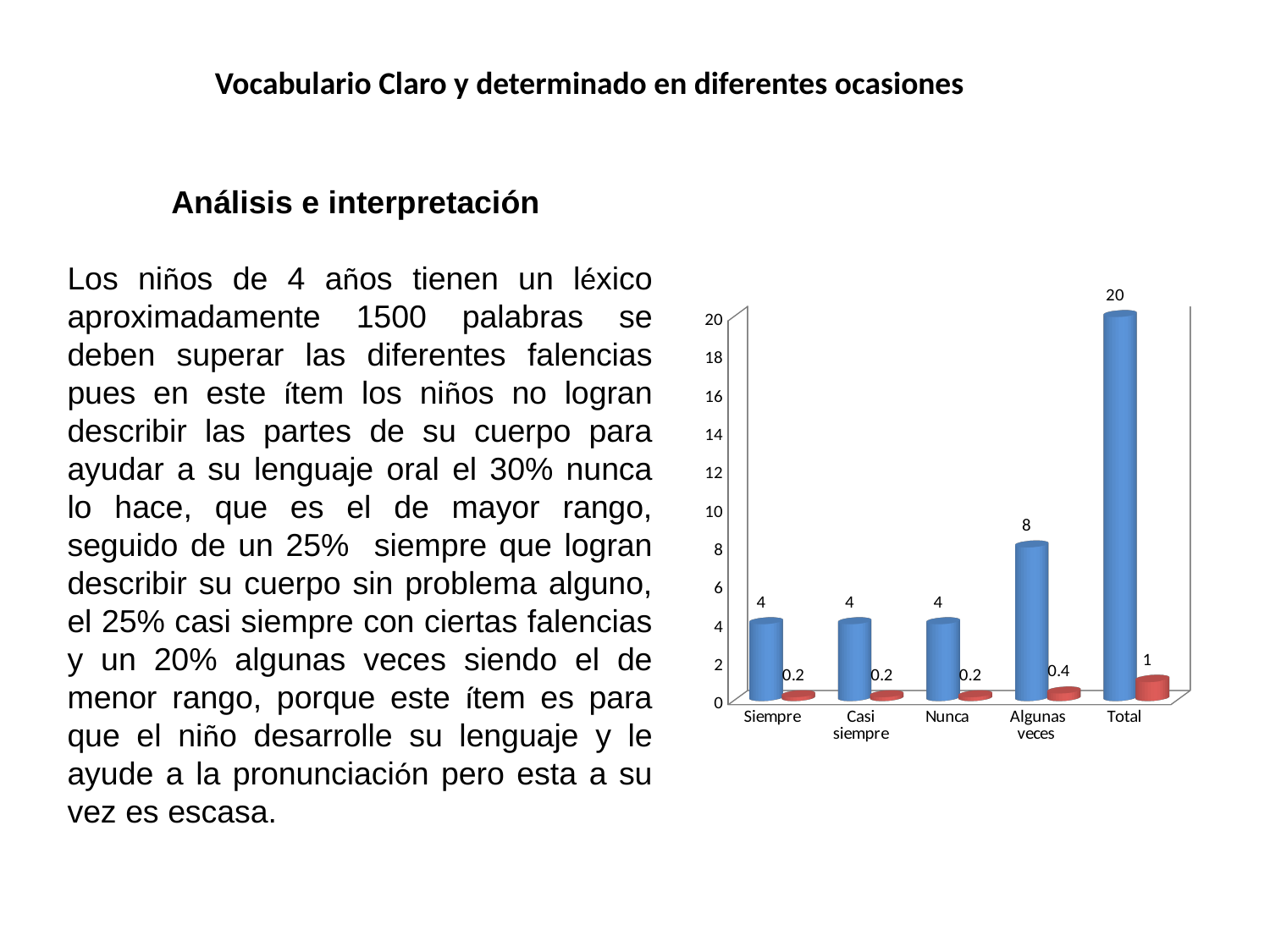
What is the value of the blue bar for Total? 20 What is the value of the red bar for Total? 1 What is the difference between the blue bar values for Total and Algunas veces? 12 What is the difference between the red bar values for Algunas veces and Casi siempre? 0.2 How many categories are shown on the x axis of the chart? 5 What is the value of the blue bar for Nunca? 4 What is the value of the red bar for Algunas veces? 0.4 What type of chart is shown on the slide? bar chart Excluding Total, which category has the highest blue bar? Algunas veces Which is larger, the blue bar for Algunas veces or the blue bar for Siempre? Algunas veces What is the value of the blue bar for Algunas veces? 8 Which category has the highest blue bar? Total